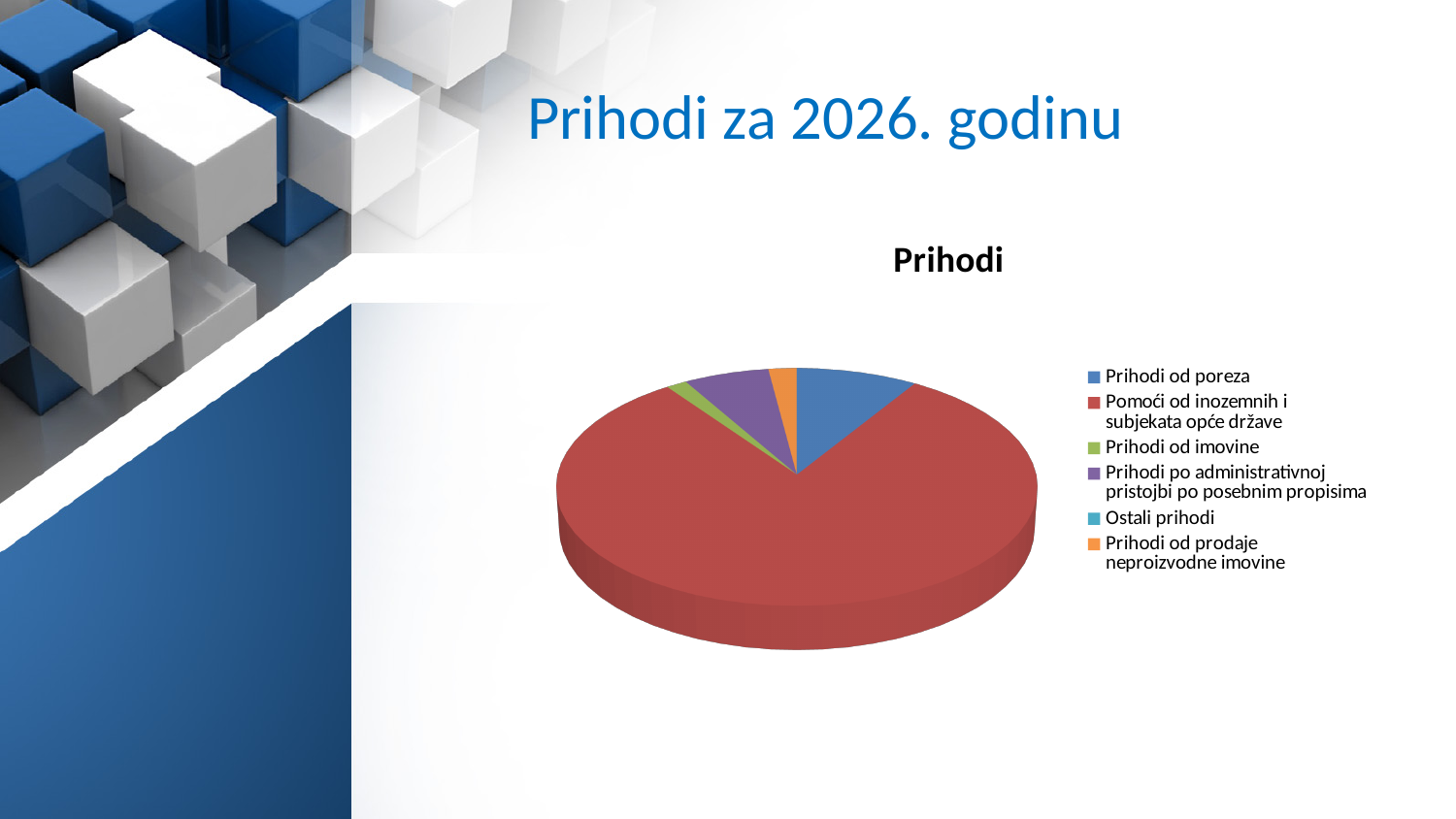
Which slice is larger: Prihodi od poreza or Prihodi od imovine? Prihodi od poreza How many categories does the legend of the pie chart list? 6 Which slice is larger: Prihodi po administrativnoj pristojbi po posebnim propisima or Prihodi od imovine? Prihodi po administrativnoj pristojbi po posebnim propisima What colour is the slice for Pomoći od inozemnih i subjekata opće države? red Which slice is larger: Prihodi od poreza or Prihodi od prodaje neproizvodne imovine? Prihodi od poreza What kind of chart is shown on the slide? pie chart What is the title of the chart? Prihodi Which category has the largest slice of the pie? Pomoći od inozemnih i subjekata opće države